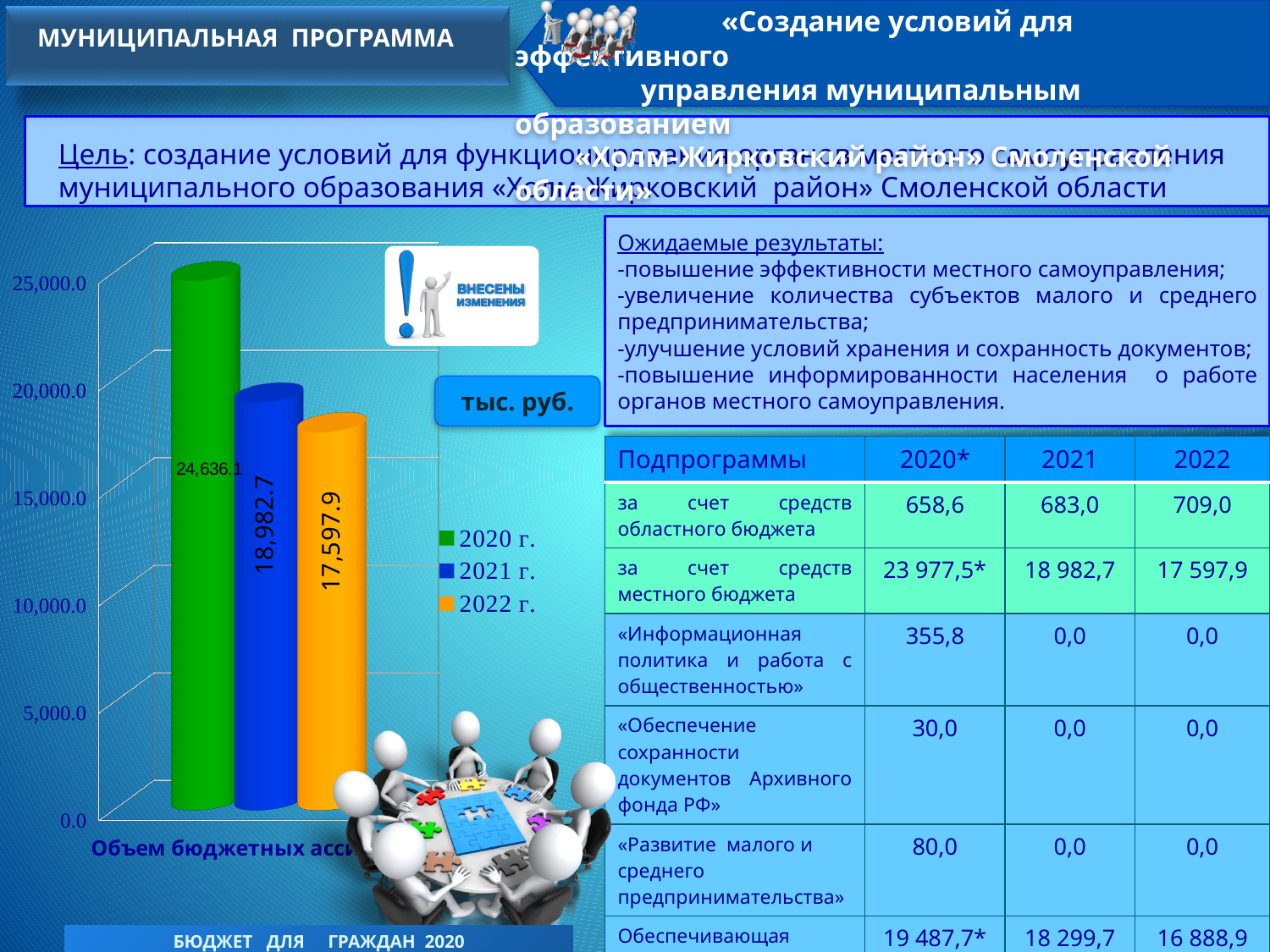
Which year has the lowest bar in the chart? 2022 г. What is the difference between the values for 2021 г. and 2022 г.? 1,384.8 What is the value of the bar for 2022 г.? 17,597.9 How many bars are plotted in the chart? 3 Is the value for 2020 г. greater or less than 20,000.0? greater What is the difference between the values for 2020 г. and 2021 г.? 5,653.4 How many entries does the chart legend list? 3 What is the value of the bar for 2020 г.? 24,636.1 Which is larger, the value for 2021 г. or the value for 2022 г.? 2021 г. Which year has the highest bar in the chart? 2020 г. What is the value of the bar for 2021 г.? 18,982.7 What kind of chart is shown on the slide? bar chart